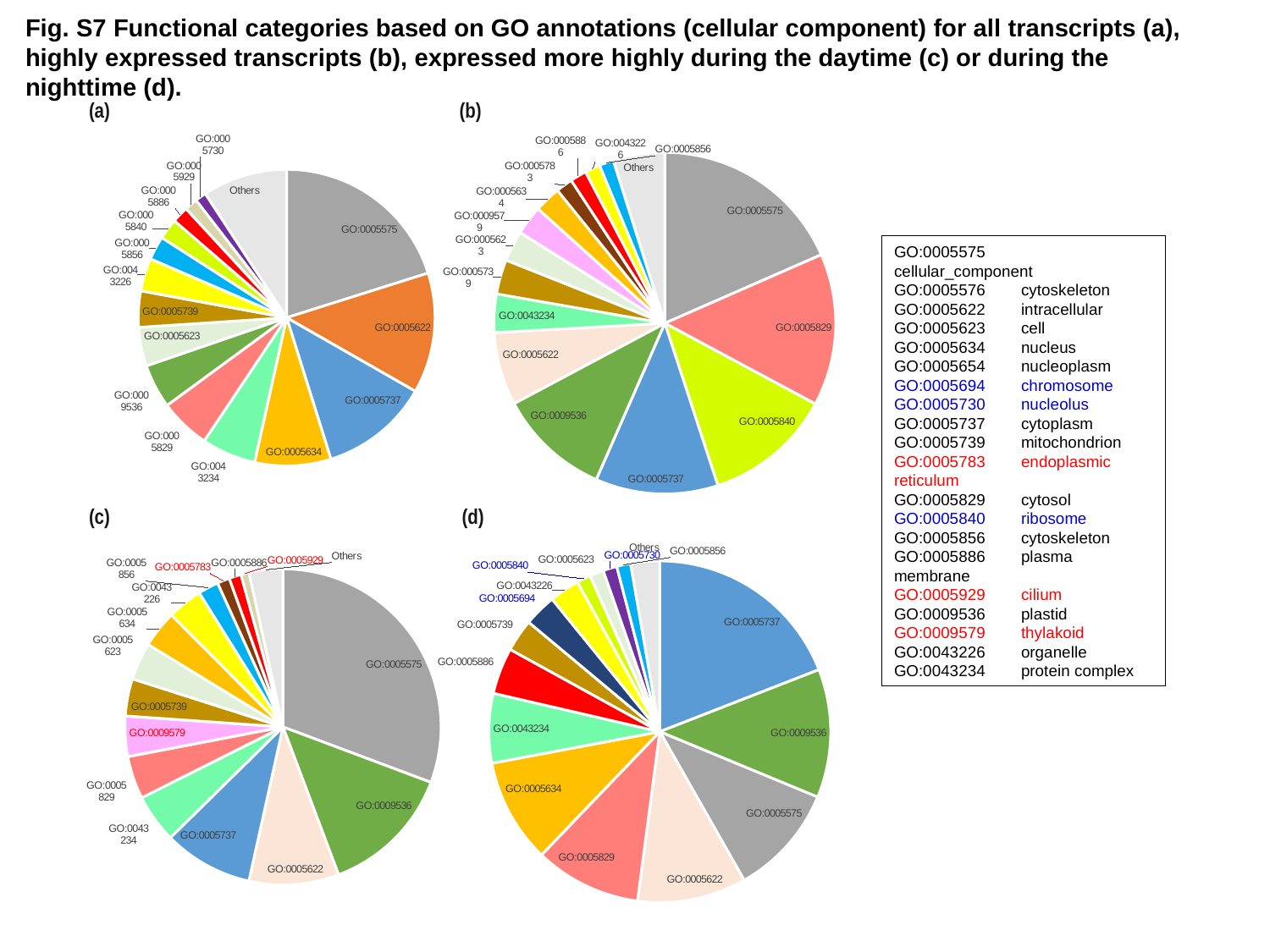
In panel (c), which slice is larger, GO:0009536 or GO:0005622? GO:0009536 In panel (d), which slice is larger, GO:0005737 or GO:0005575? GO:0005737 How many pie charts are shown on the slide? 4 According to the key on the right, what cellular component does GO:0009536 correspond to? plastid According to the key on the right, what cellular component does GO:0005840 correspond to? ribosome In panel (b), which category has the largest slice? GO:0005575 What kind of chart is used in panel (a)? pie chart In panel (b), which slice is larger, GO:0005840 or GO:0043234? GO:0005840 In panel (c), which category has the largest slice? GO:0005575 In panel (a), which category has the largest slice? GO:0005575